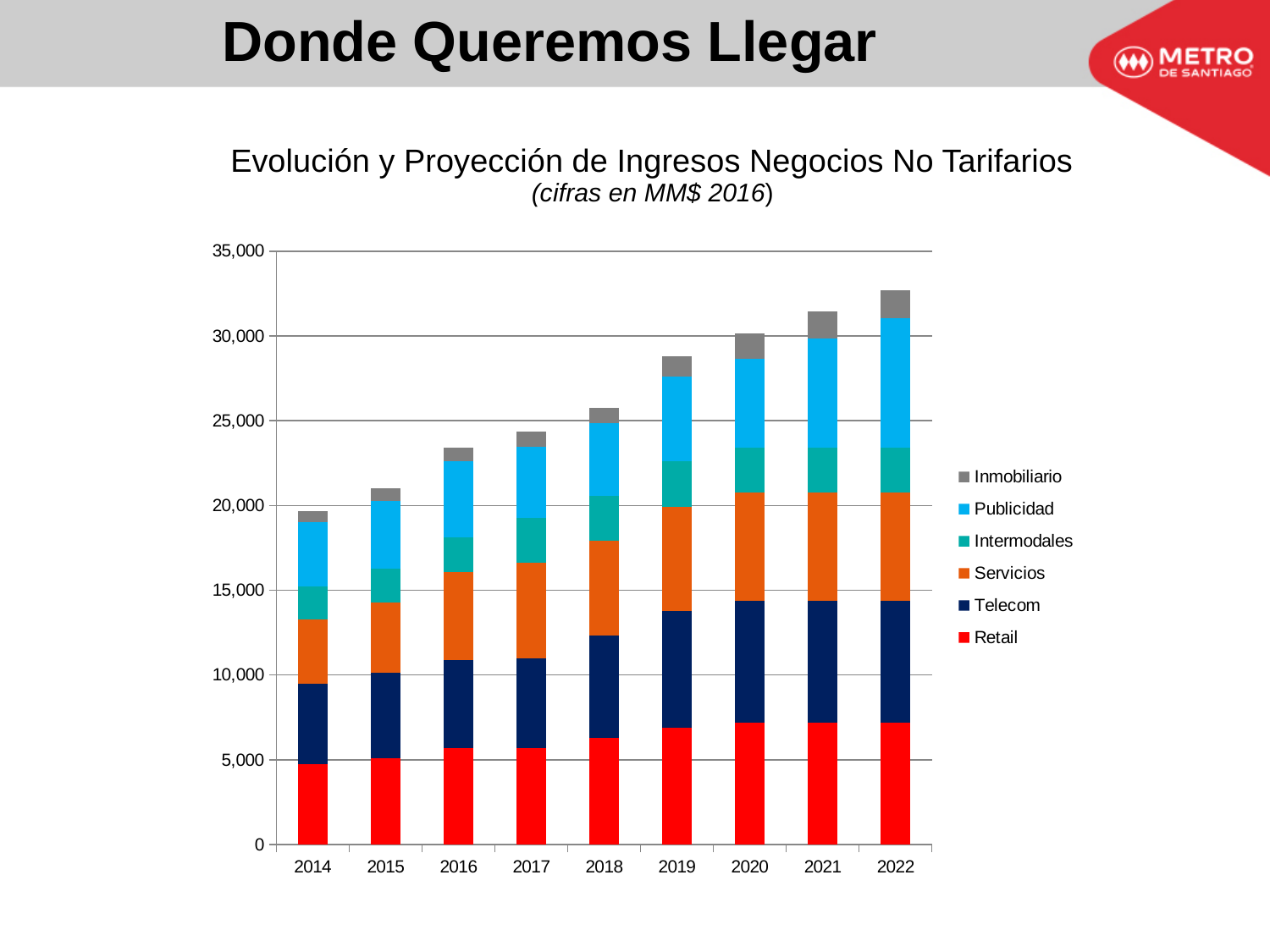
What kind of chart is shown on the slide? Stacked bar chart Which is larger, the total stacked bar for 2014 or for 2022? 2022 How many years are shown along the x axis of the chart? 9 Do the total bar heights rise or fall from 2014 to 2022? Rise Is the total stacked bar for 2016 greater or less than 25,000? less What is the title of the chart? Evolución y Proyección de Ingresos Negocios No Tarifarios Which year has the tallest stacked bar? 2022 Is the Retail value for 2022 greater or less than 5,000? greater Is the total stacked bar for 2022 greater or less than 30,000? greater Which year has the shortest stacked bar? 2014 Which series is shown in red at the bottom of each stacked bar? Retail How many series does the chart's legend list? 6